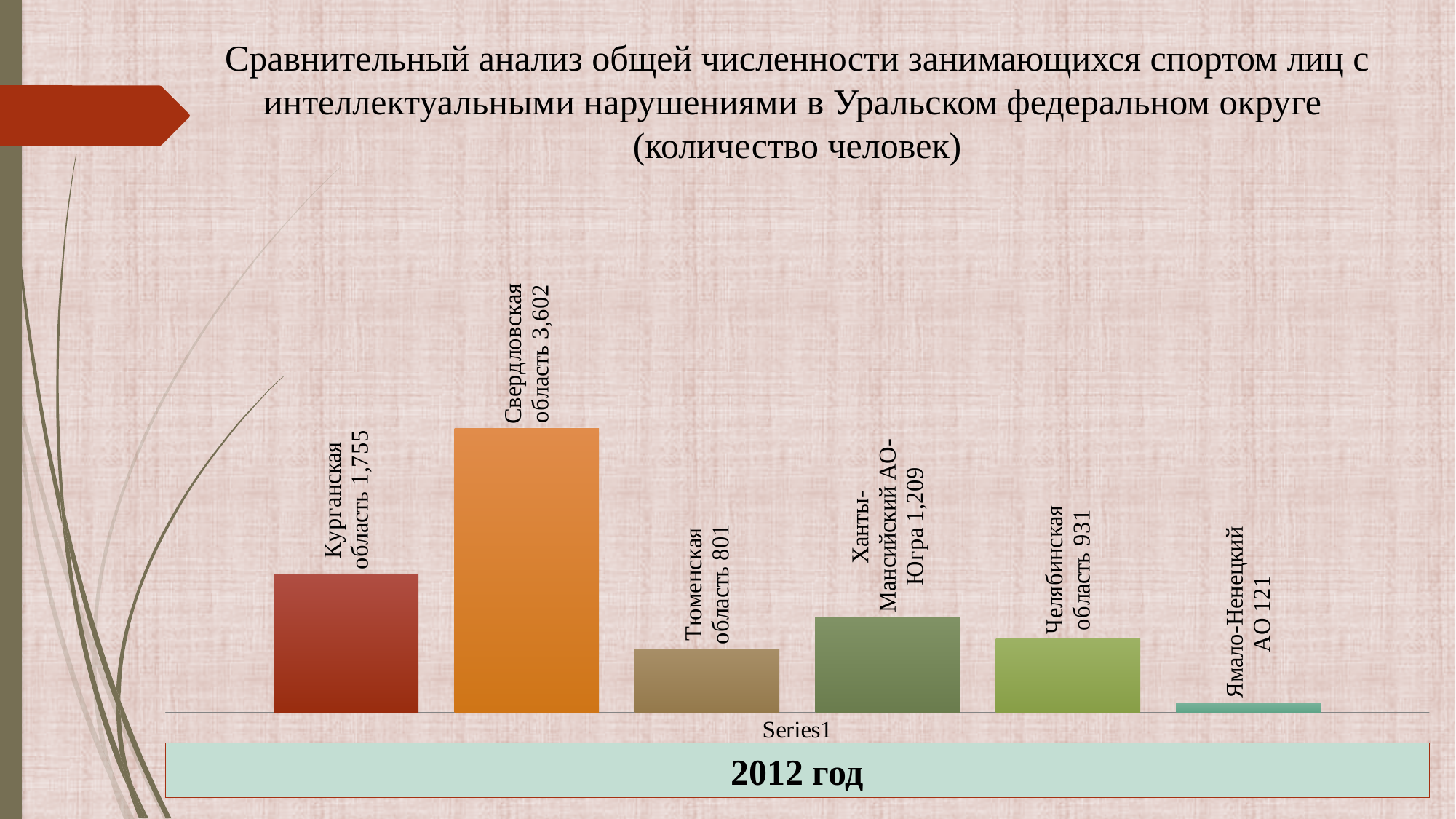
What is the value for Ямало-Ненецкий АО? 121 What is the difference between the values for Челябинская область and Тюменская область? 130 Which region has the highest value? Свердловская область What is the value for Курганская область? 1,755 What is the value for Тюменская область? 801 What year is indicated in the box below the chart? 2012 год What is the difference between the values for Свердловская область and Курганская область? 1,847 What kind of chart is shown on the slide? Bar chart What is the value for Свердловская область? 3,602 Which region has the lowest value? Ямало-Ненецкий АО How many regions (bars) are shown in the chart? 6 Which is larger, the value for Ханты-Мансийский АО-Югра or the value for Челябинская область? Ханты-Мансийский АО-Югра